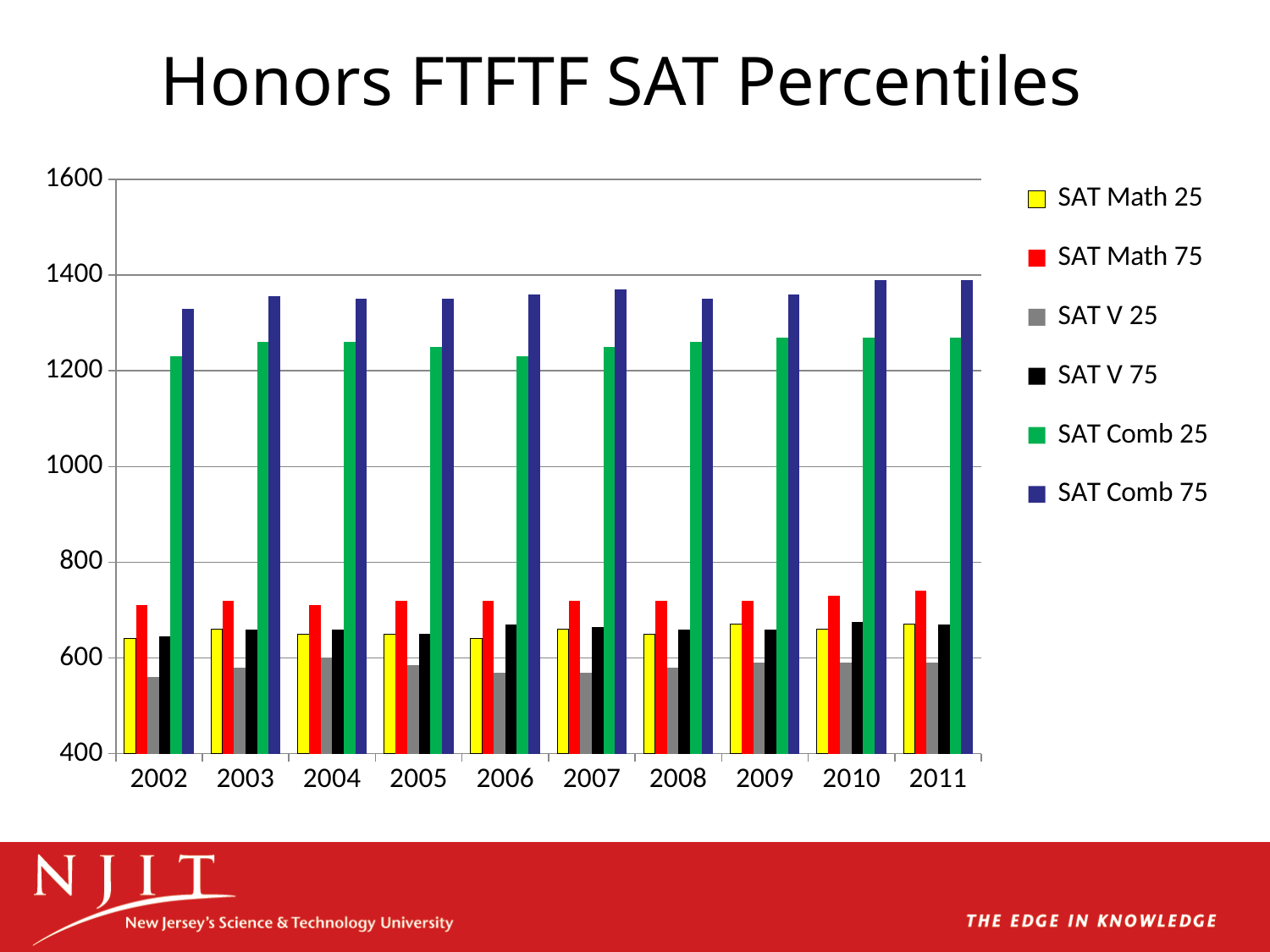
Which colour represents SAT Comb 25 in the legend? green How many series does the legend list? 6 Is the value for SAT Comb 25 in 2002 greater or less than 1200? greater Is the value for SAT Comb 75 in 2002 greater or less than 1400? less Is the value for SAT V 25 in 2002 greater or less than 600? less Which series has the lowest values in every year? SAT V 25 In which year is SAT Comb 75 lowest? 2002 Which series has the highest values in every year? SAT Comb 75 How many years are shown along the x axis? 10 What is the title of the chart? Honors FTFTF SAT Percentiles What kind of chart is shown on the slide? bar chart